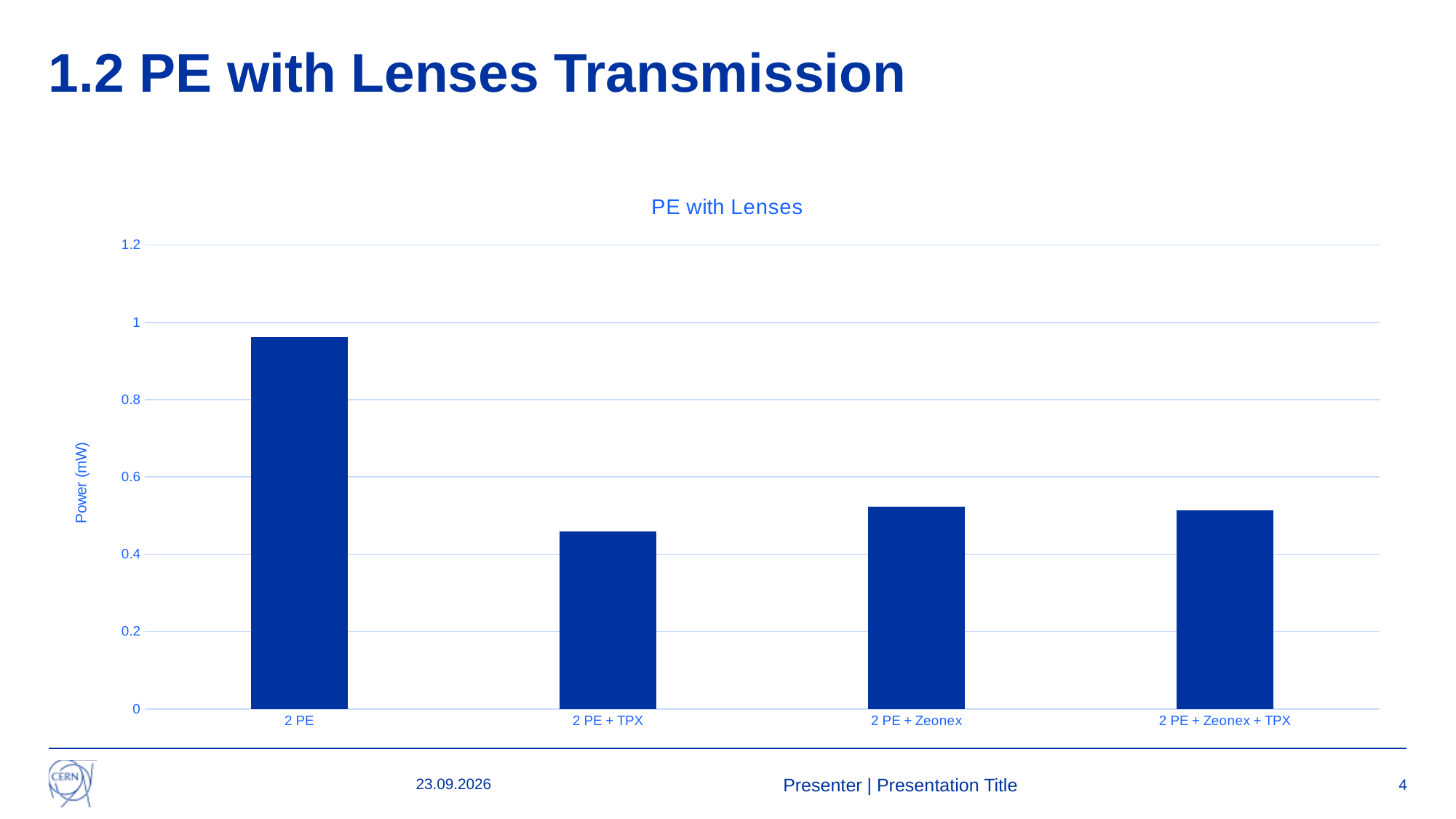
Which category has the highest value in the PE with Lenses chart? 2 PE Which has the larger value, 2 PE or 2 PE + Zeonex? 2 PE Is the value for 2 PE + TPX greater or less than 0.6? less Is the value for 2 PE greater or less than 0.8? greater What is the label of the vertical axis? Power (mW) Which has the larger value, 2 PE or 2 PE + TPX? 2 PE What is the title of the chart? PE with Lenses Which category has the lowest value in the PE with Lenses chart? 2 PE + TPX How many categories are plotted in the PE with Lenses chart? 4 What kind of chart is shown on the slide? bar chart Is the value for 2 PE greater or less than 1? less